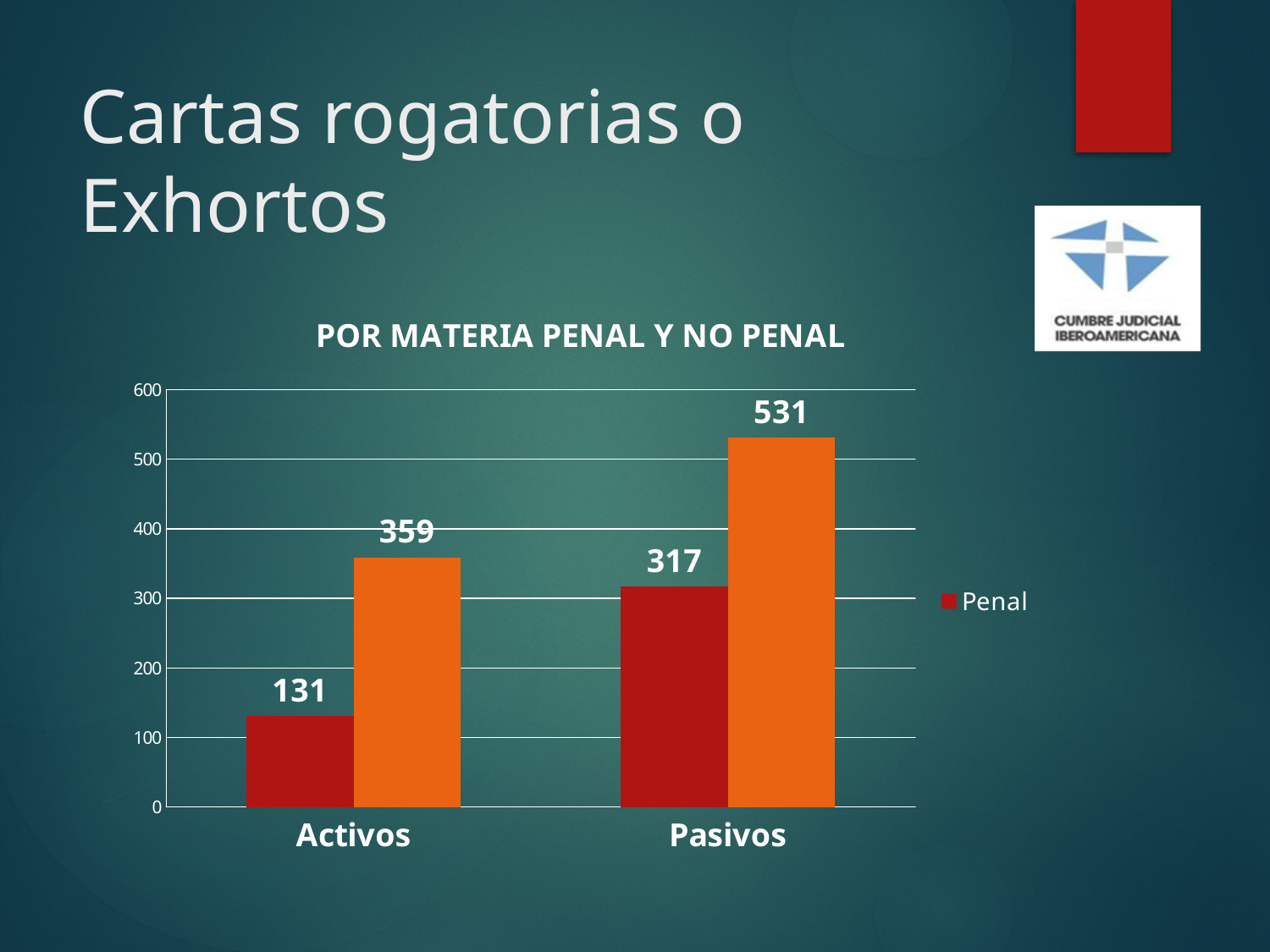
How many categories are shown on the x axis? 2 What is the difference between the orange bar values for Pasivos and Activos? 172 What is the value of the orange bar for Activos? 359 What is the value of the orange bar for Pasivos? 531 What is the Penal value for Pasivos? 317 What kind of chart is shown on the slide? Bar chart What is the difference between the Penal values for Pasivos and Activos? 186 What is the title of the chart? POR MATERIA PENAL Y NO PENAL Which is larger: the orange bar for Activos or the Penal bar for Pasivos? The orange bar for Activos What is the Penal value for Activos? 131 Which category has the higher Penal value, Activos or Pasivos? Pasivos Is the value of the orange bar for Pasivos greater or less than 500? greater